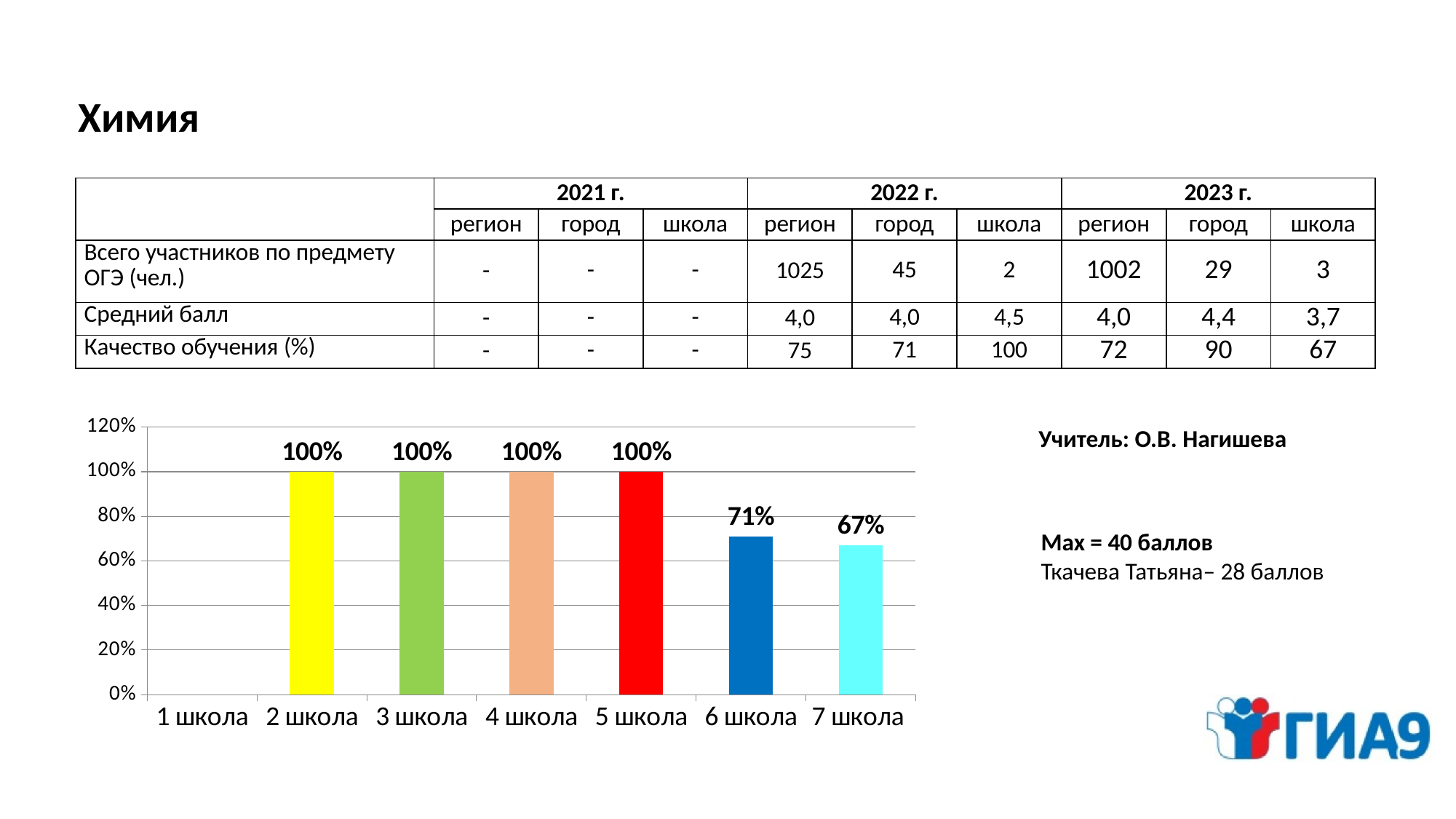
Which labelled bar has the lowest value in the bar chart? 7 школа How many school categories are shown on the x axis of the bar chart? 7 Which is larger, the value for 6 школа or the value for 7 школа? 6 школа What colour is the bar for 5 школа? red Is the value for 6 школа greater or less than 80%? less What type of chart is shown on the slide? bar chart What is the value for 2 школа in the bar chart? 100% What is the value for 5 школа in the bar chart? 100% What is the difference between the values for 3 школа and 6 школа? 29% What is the difference between the values for 6 школа and 7 школа? 4% What is the value for 7 школа in the bar chart? 67% What is the value for 6 школа in the bar chart? 71%